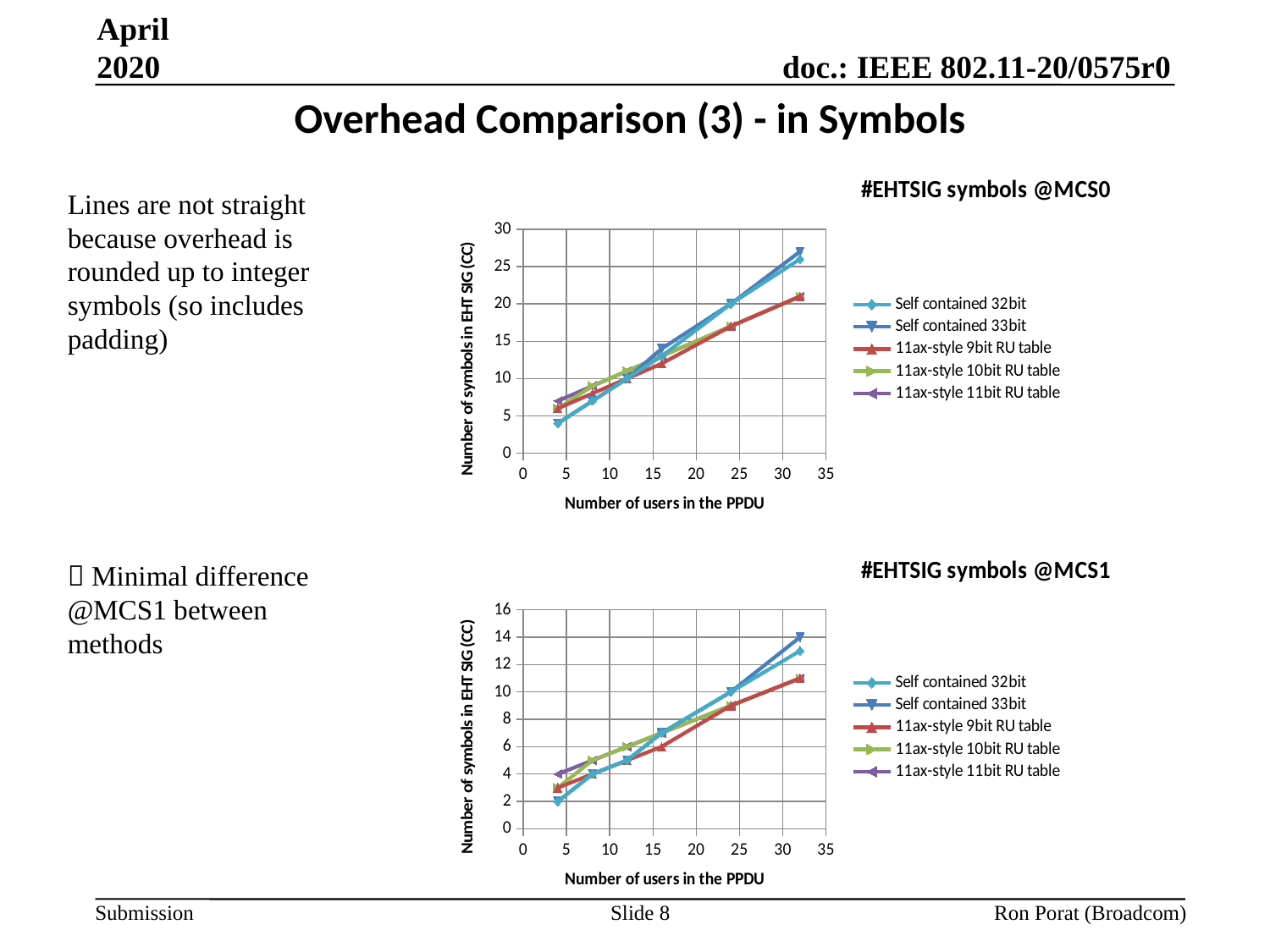
In the "#EHTSIG symbols @MCS1" chart, at 32 users, which is larger: Self contained 32bit or 11ax-style 9bit RU table? Self contained 32bit In the "#EHTSIG symbols @MCS0" chart, do the values rise or fall as the number of users in the PPDU increases? rise What is the y-axis title of the "#EHTSIG symbols @MCS0" chart? Number of symbols in EHT SIG (CC) In the "#EHTSIG symbols @MCS1" chart, is the value for Self contained 32bit at 4 users greater or less than 4? less How many series does the legend of the "#EHTSIG symbols @MCS1" chart list? 5 What kind of chart is the "#EHTSIG symbols @MCS0" chart? line chart What is the x-axis title of the "#EHTSIG symbols @MCS1" chart? Number of users in the PPDU In the "#EHTSIG symbols @MCS0" chart, is the value for Self contained 33bit at 32 users greater or less than 25? greater In the "#EHTSIG symbols @MCS1" chart, is the value for Self contained 33bit at 32 users greater or less than 12? greater In the "#EHTSIG symbols @MCS0" chart, at 32 users, which is larger: Self contained 33bit or 11ax-style 9bit RU table? Self contained 33bit In the "#EHTSIG symbols @MCS0" chart, which series has the highest value at 32 users? Self contained 33bit